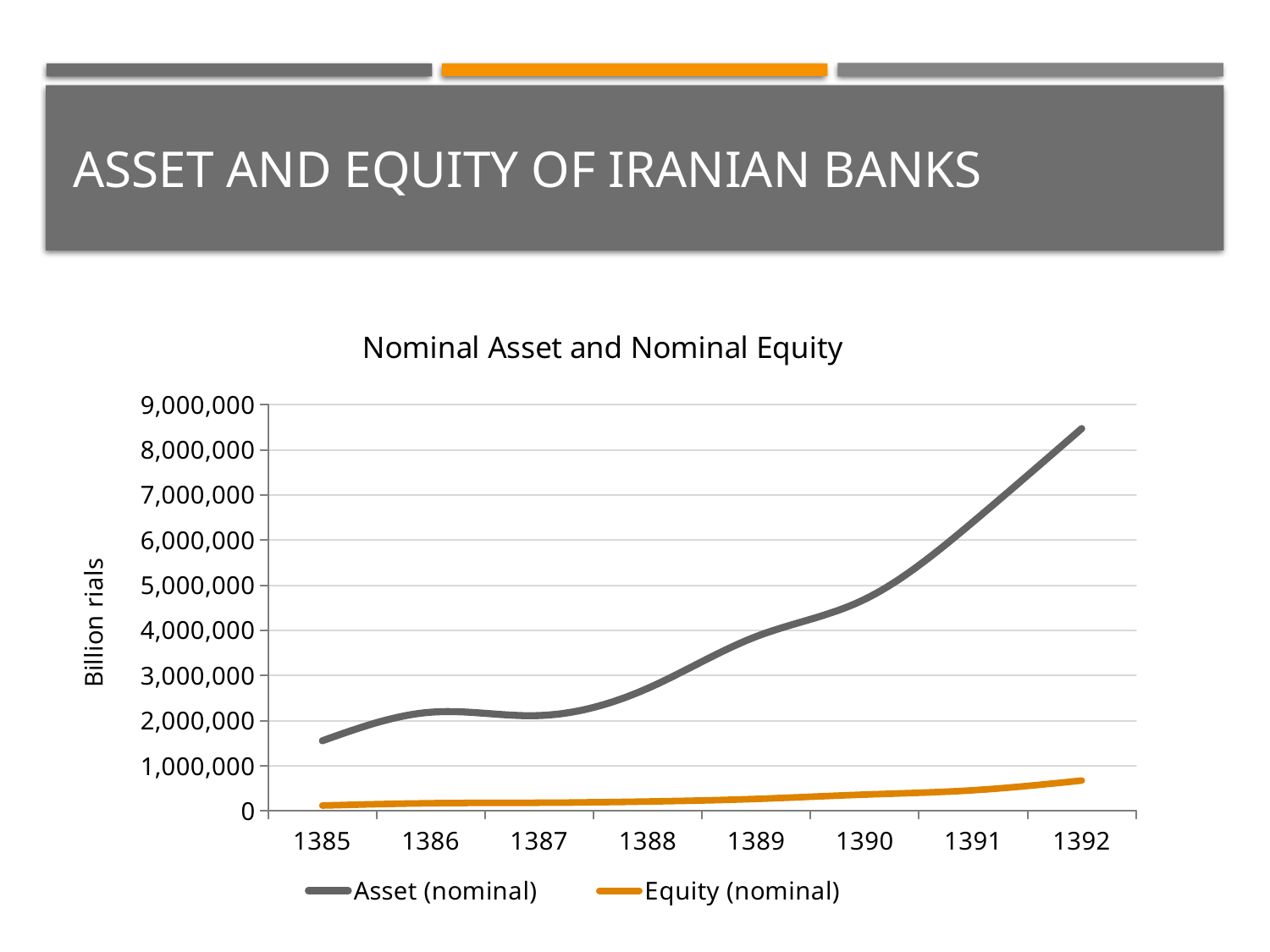
Is the value for Asset (nominal) in 1392 greater or less than 8,000,000? greater Is the value for Asset (nominal) in 1385 greater or less than 2,000,000? less Does Asset (nominal) generally rise or fall from 1385 to 1392? rise What is the label on the vertical axis? Billion rials What kind of chart is shown on the slide? line chart How many years are plotted along the x axis? 8 In which year is Asset (nominal) highest? 1392 Is the value for Equity (nominal) in 1392 greater or less than 1,000,000? less How many series does the legend list? 2 In which year is Asset (nominal) lowest? 1385 What is the title of the chart? Nominal Asset and Nominal Equity Which series is larger in 1392, Asset (nominal) or Equity (nominal)? Asset (nominal)